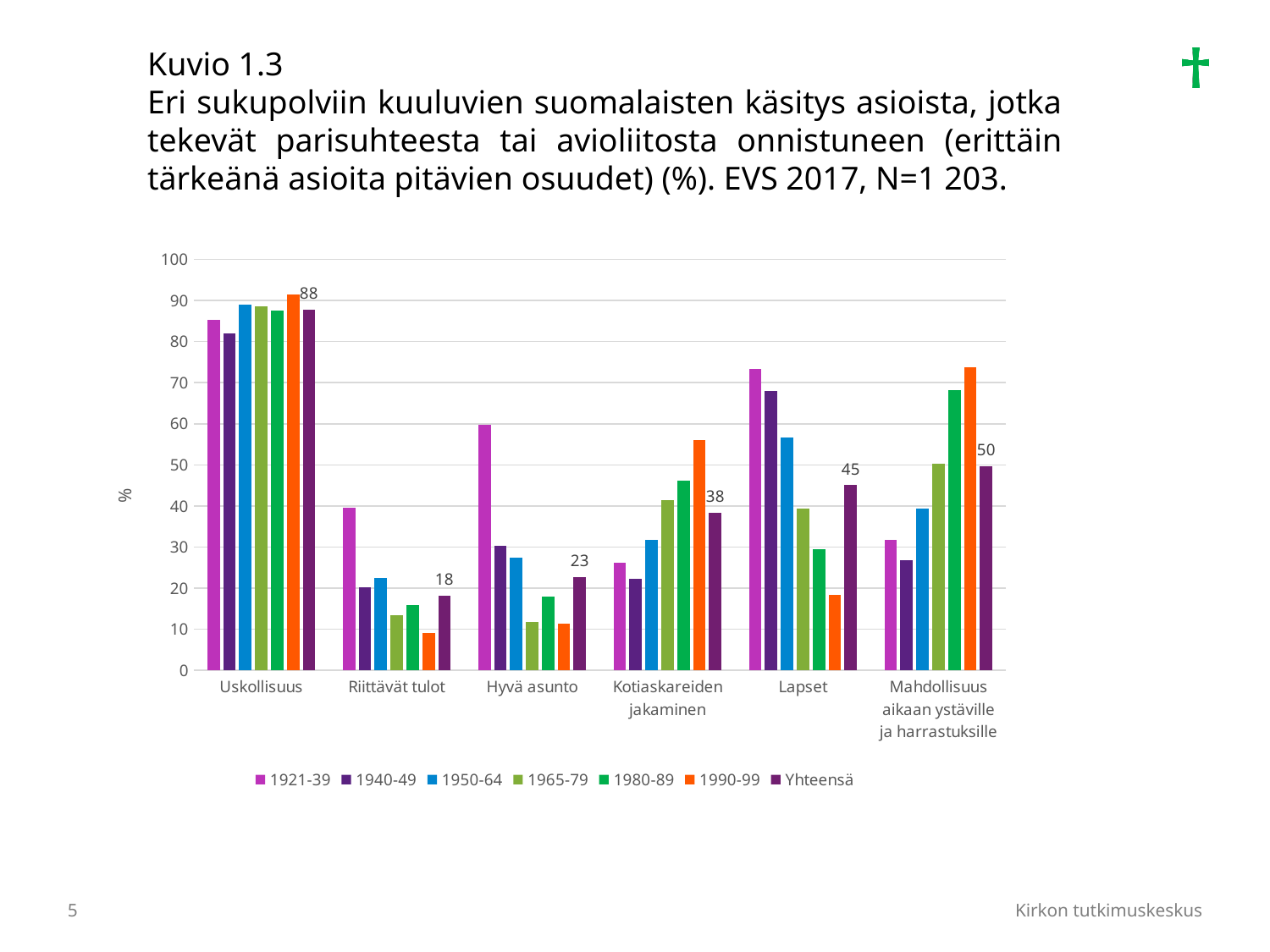
Which category has the highest Yhteensä value? Uskollisuus Is the value for 1921-39 in the Lapset category greater or less than 60? greater Which category has the lowest Yhteensä value? Riittävät tulot How many series does the legend list? 7 What is the Yhteensä value for Mahdollisuus aikaan ystäville ja harrastuksille? 50 What is the Yhteensä value for Riittävät tulot? 18 What is the difference between the Yhteensä values for Uskollisuus and Riittävät tulot? 70 What is the Yhteensä value for Lapset? 45 Which has the larger Yhteensä value, Lapset or Kotiaskareiden jakaminen? Lapset Is the value for 1990-99 in the Riittävät tulot category greater or less than 20? less How many categories are shown on the x axis? 6 What is the Yhteensä value for Uskollisuus? 88